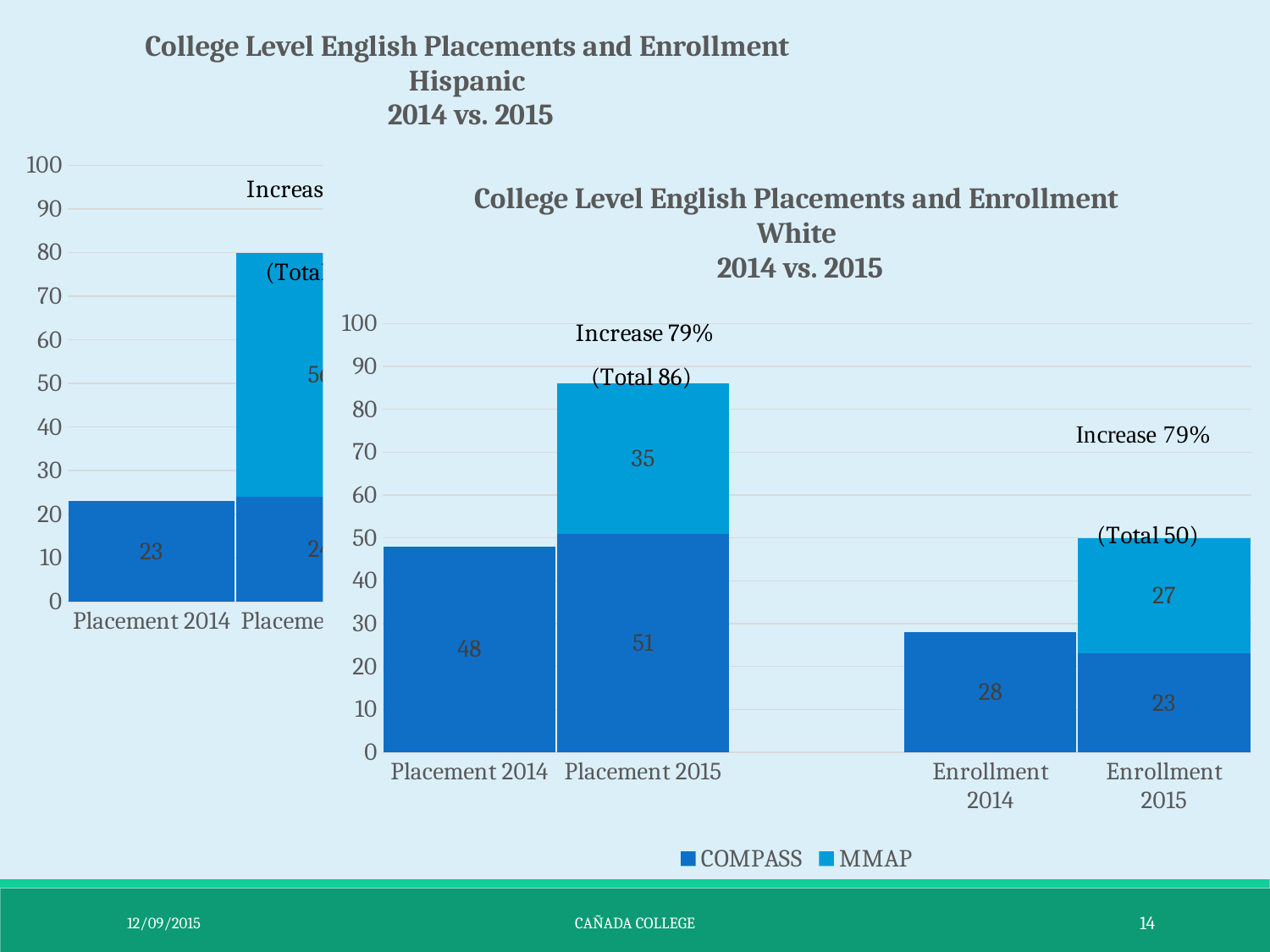
In the 'College Level English Placements and Enrollment White 2014 vs. 2015' chart, what is the total of the stacked bar for Placement 2015? 86 In the 'College Level English Placements and Enrollment White 2014 vs. 2015' chart, what is the COMPASS value for Enrollment 2015? 23 In the 'College Level English Placements and Enrollment Hispanic 2014 vs. 2015' chart on the left, what is the COMPASS value for Placement 2014? 23 In the 'College Level English Placements and Enrollment White 2014 vs. 2015' chart, which category has the lowest COMPASS value? Enrollment 2015 In the 'College Level English Placements and Enrollment White 2014 vs. 2015' chart, what is the MMAP value for Placement 2015? 35 What kind of chart is the 'College Level English Placements and Enrollment White 2014 vs. 2015' chart? Stacked bar chart In the 'College Level English Placements and Enrollment White 2014 vs. 2015' chart, what is the COMPASS value for Placement 2014? 48 In the 'College Level English Placements and Enrollment White 2014 vs. 2015' chart, how many series does the legend list? 2 In the 'College Level English Placements and Enrollment White 2014 vs. 2015' chart, what is the total of the stacked bar for Enrollment 2015? 50 In the 'College Level English Placements and Enrollment White 2014 vs. 2015' chart, which is larger: the COMPASS value for Enrollment 2014 or the COMPASS value for Enrollment 2015? Enrollment 2014 In the 'College Level English Placements and Enrollment White 2014 vs. 2015' chart, what percentage increase is labelled above the Placement 2015 bar? 79% In the 'College Level English Placements and Enrollment White 2014 vs. 2015' chart, what is the difference between the COMPASS values for Placement 2015 and Placement 2014? 3